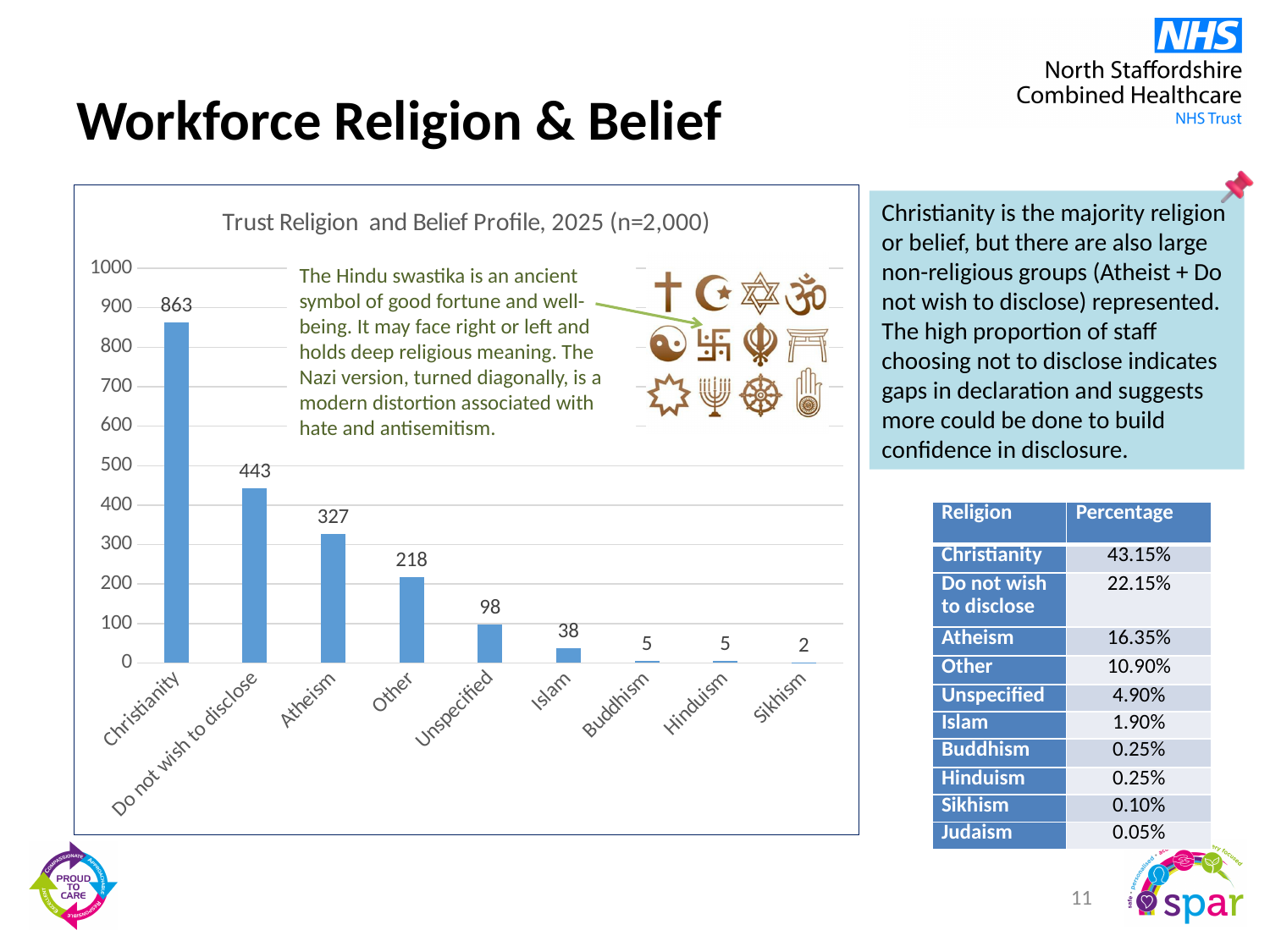
What is the difference between the values for Christianity and Do not wish to disclose? 420 What is the value for Atheism in the chart? 327 What is the value for Unspecified in the chart? 98 What is the value for Christianity in the chart? 863 What kind of chart is shown on the slide? Bar chart What is the title of the chart? Trust Religion and Belief Profile, 2025 (n=2,000) Which category has the highest value in the chart? Christianity What is the difference between the values for Atheism and Other? 109 How many categories are shown on the x axis of the chart? 9 Do the values rise or fall from left to right along the x axis? Fall Which category has the lowest value in the chart? Sikhism Which is larger, the value for Other or the value for Islam? Other